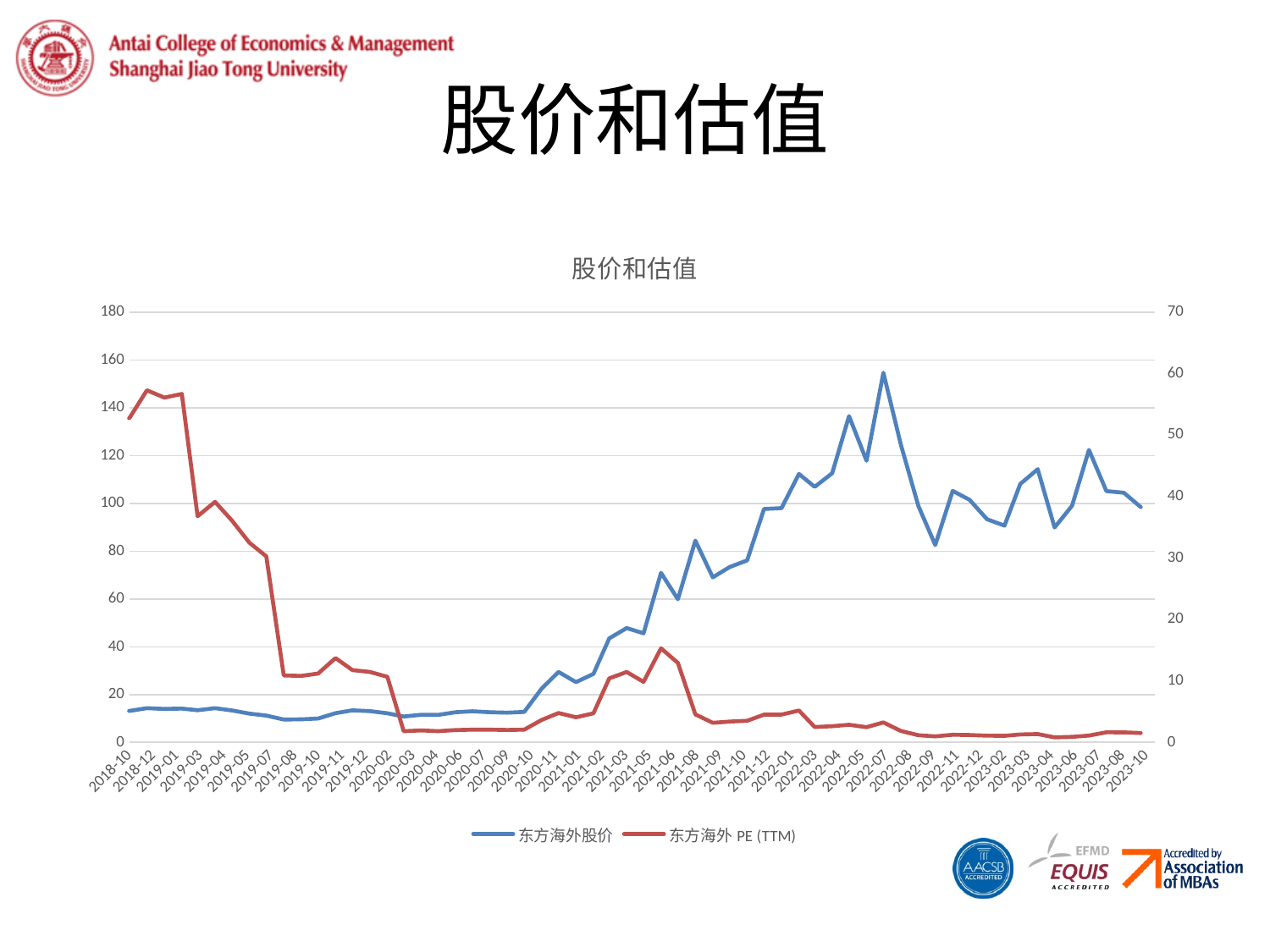
What is the title of the chart? 股价和估值 Reading against the left axis, is the value of 东方海外股价 at 2022-07 greater or less than 140? greater At 2018-10, which line is plotted higher on the chart, 东方海外股价 or 东方海外 PE (TTM)? 东方海外 PE (TTM) What kind of chart is shown on the slide? line chart At which date does the 东方海外股价 line reach its highest point? 2022-07 Reading against the left axis, is the value of 东方海外股价 at 2018-10 greater or less than 20? less At 2023-10, which line is plotted higher on the chart, 东方海外股价 or 东方海外 PE (TTM)? 东方海外股价 Which series is drawn in red according to the legend? 东方海外 PE (TTM) Does the 东方海外股价 line rise or fall overall from 2020-10 to 2022-07? rise Does the 东方海外 PE (TTM) line rise or fall overall from 2018-10 to 2020-03? fall How many series does the chart's legend list? 2 Is the value of 东方海外 PE (TTM) at 2023-10 greater or less than 10? less